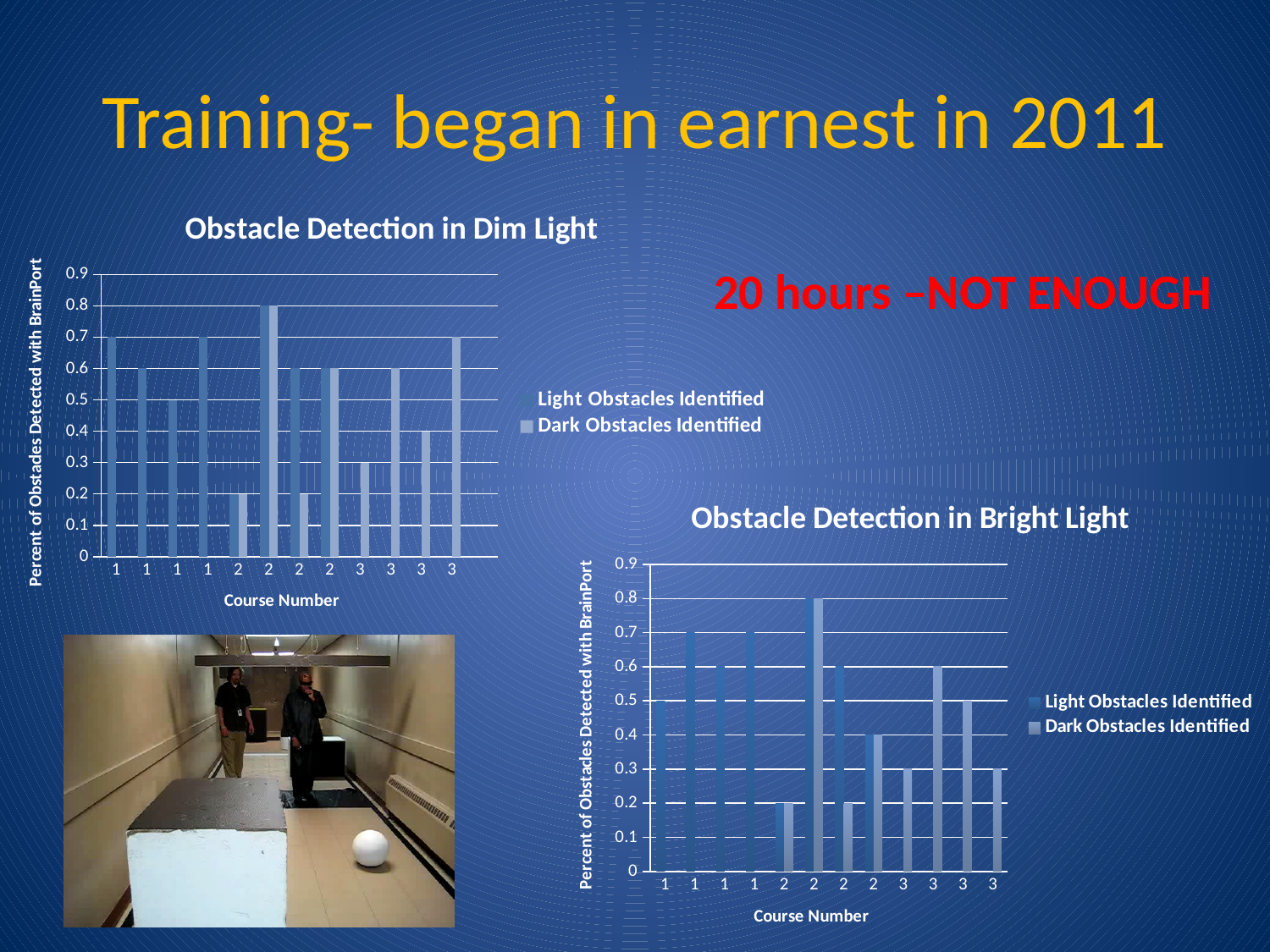
In the 'Obstacle Detection in Bright Light' chart, what is the highest value reached by any bar? 0.8 How many series does the legend of the 'Obstacle Detection in Dim Light' chart list? 2 In the 'Obstacle Detection in Dim Light' chart, what is the value of the last (rightmost) bar? 0.7 What kind of chart is 'Obstacle Detection in Dim Light'? bar chart In the 'Obstacle Detection in Dim Light' chart, what is the difference between the tallest bar and the first bar? 0.1 In the 'Obstacle Detection in Bright Light' chart, what is the value of the first (leftmost) bar? 0.5 In the 'Obstacle Detection in Bright Light' chart, what is the value of the last (rightmost) bar? 0.3 What is the x-axis title of the 'Obstacle Detection in Bright Light' chart? Course Number In the 'Obstacle Detection in Dim Light' chart, what is the value of the first (leftmost) bar? 0.7 In the 'Obstacle Detection in Dim Light' chart, what is the highest value reached by any bar? 0.8 What is the y-axis title of the 'Obstacle Detection in Dim Light' chart? Percent of Obstacles Detected with BrainPort